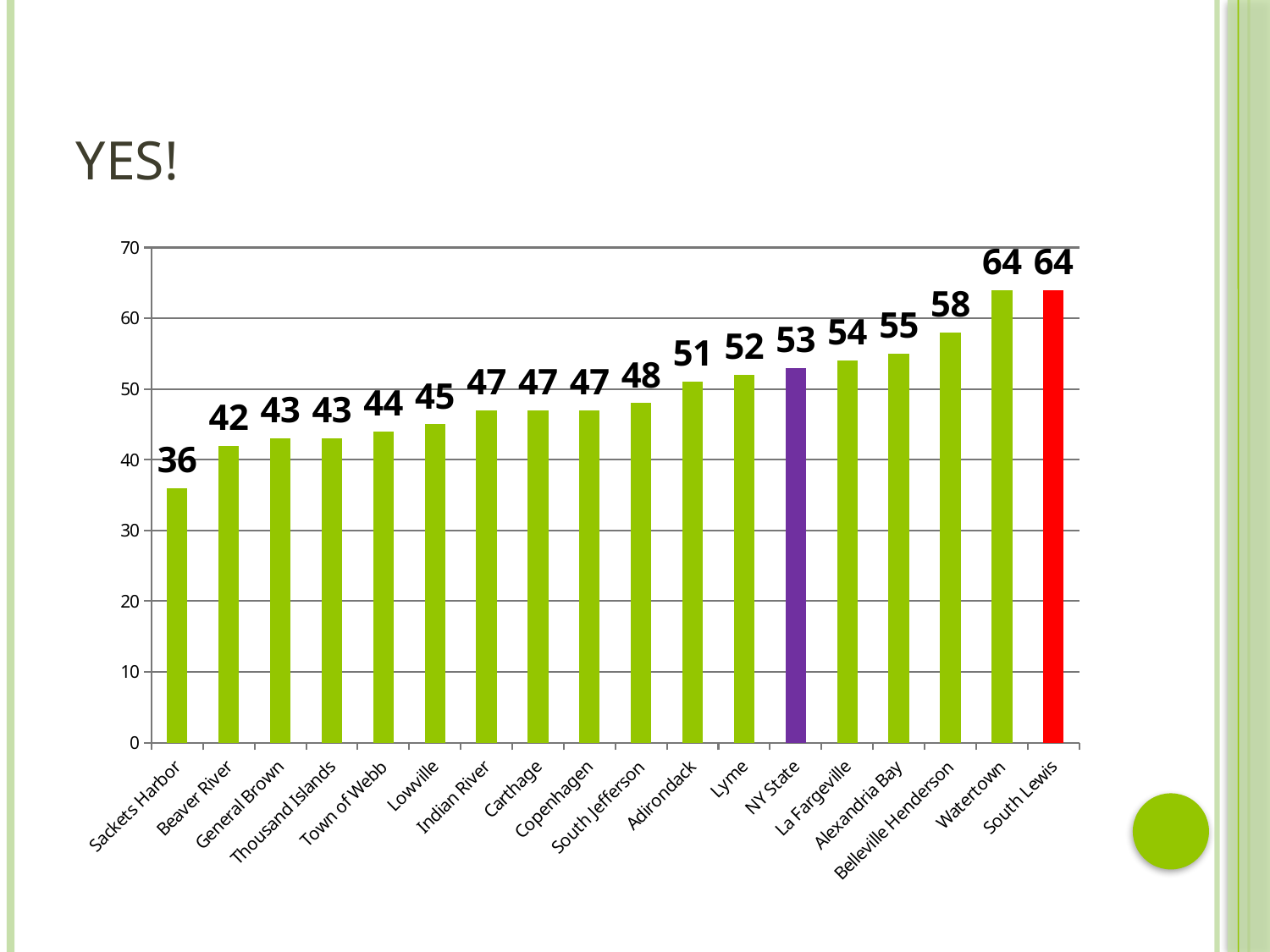
How many categories are shown on the x axis? 18 What is the value for Lowville? 45 What is the difference between the values for South Lewis and Sackets Harbor? 28 What is the value for Sackets Harbor? 36 Which is larger, the value for Lyme or the value for Adirondack? Lyme What kind of chart is shown on the slide? bar chart Is the value for Alexandria Bay greater or less than 50? greater What is the value for Belleville Henderson? 58 What is the value for NY State? 53 What is the difference between the values for Watertown and NY State? 11 Which category has the lowest value? Sackets Harbor Do the values rise or fall from left to right along the x axis? rise